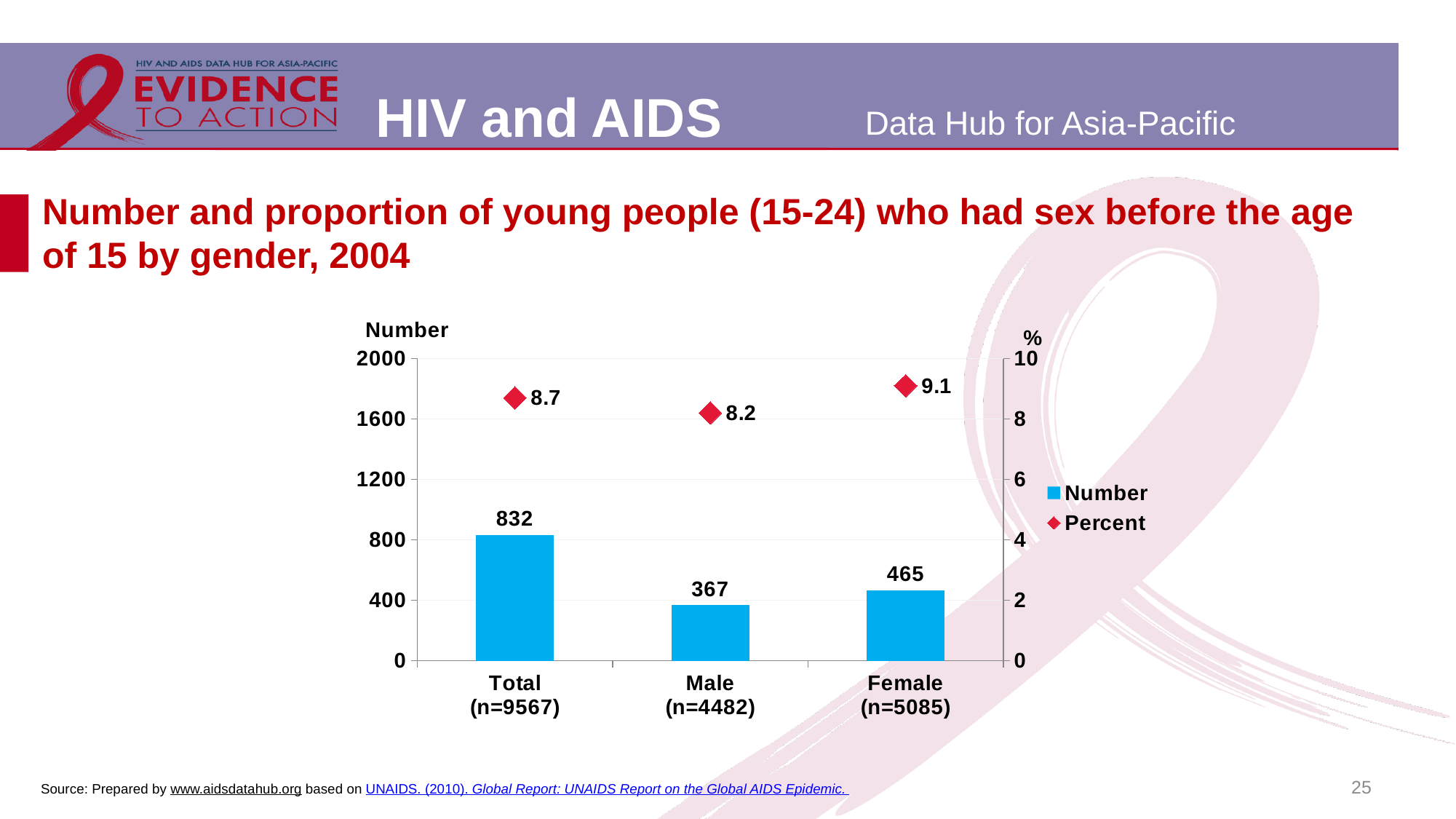
What is the Number value for Male (n=4482)? 367 Which is larger, the Percent value for Total or for Male? Total What is the Percent value for Male (n=4482)? 8.2 What is the Number value for Total (n=9567)? 832 What is the difference between the Percent values for Female and Total? 0.4 How many series does the legend list? 2 What is the Percent value for Female (n=5085)? 9.1 What is the difference between the Number values for Female and Male? 98 Which category has the lowest Number value? Male (n=4482) What is the label of the right-hand vertical axis? % Which category has the highest Percent value? Female (n=5085) How many categories are shown on the x axis? 3